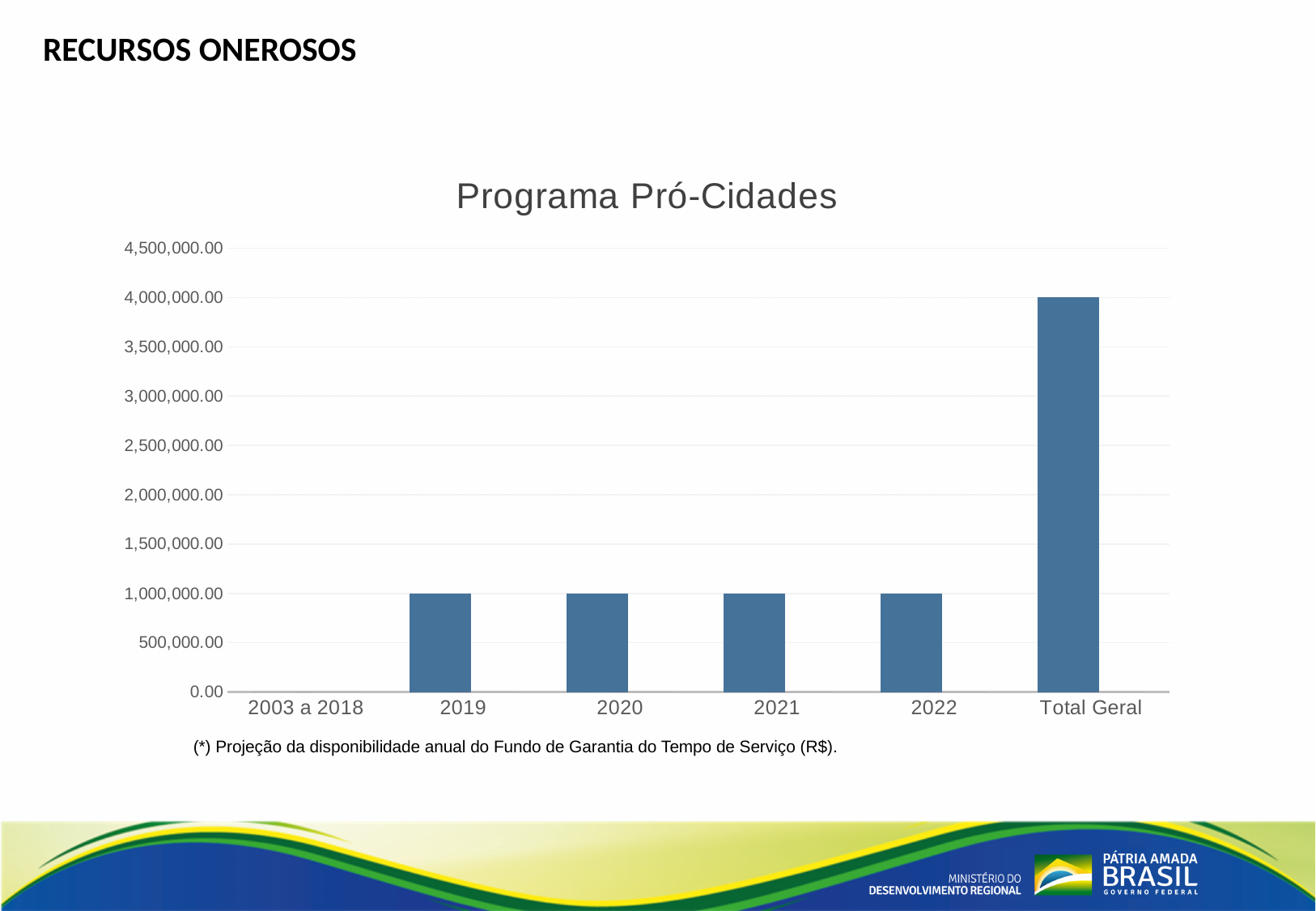
What is the highest value shown on the y axis of the chart? 4,500,000.00 What is the value for 2019 in the chart? 1,000,000.00 Which category has the lowest value in the chart? 2003 a 2018 What is the value for Total Geral in the chart? 4,000,000.00 How many categories are shown on the x axis of the chart? 6 What is the value for 2022 in the chart? 1,000,000.00 What kind of chart is shown on the slide? bar chart What is the difference between the value for Total Geral and the value for 2021? 3,000,000.00 What is the title of the chart? Programa Pró-Cidades Which is larger, the value for Total Geral or the value for 2020? Total Geral Is the value for Total Geral greater or less than 3,500,000.00? greater Which category has the highest value in the chart? Total Geral